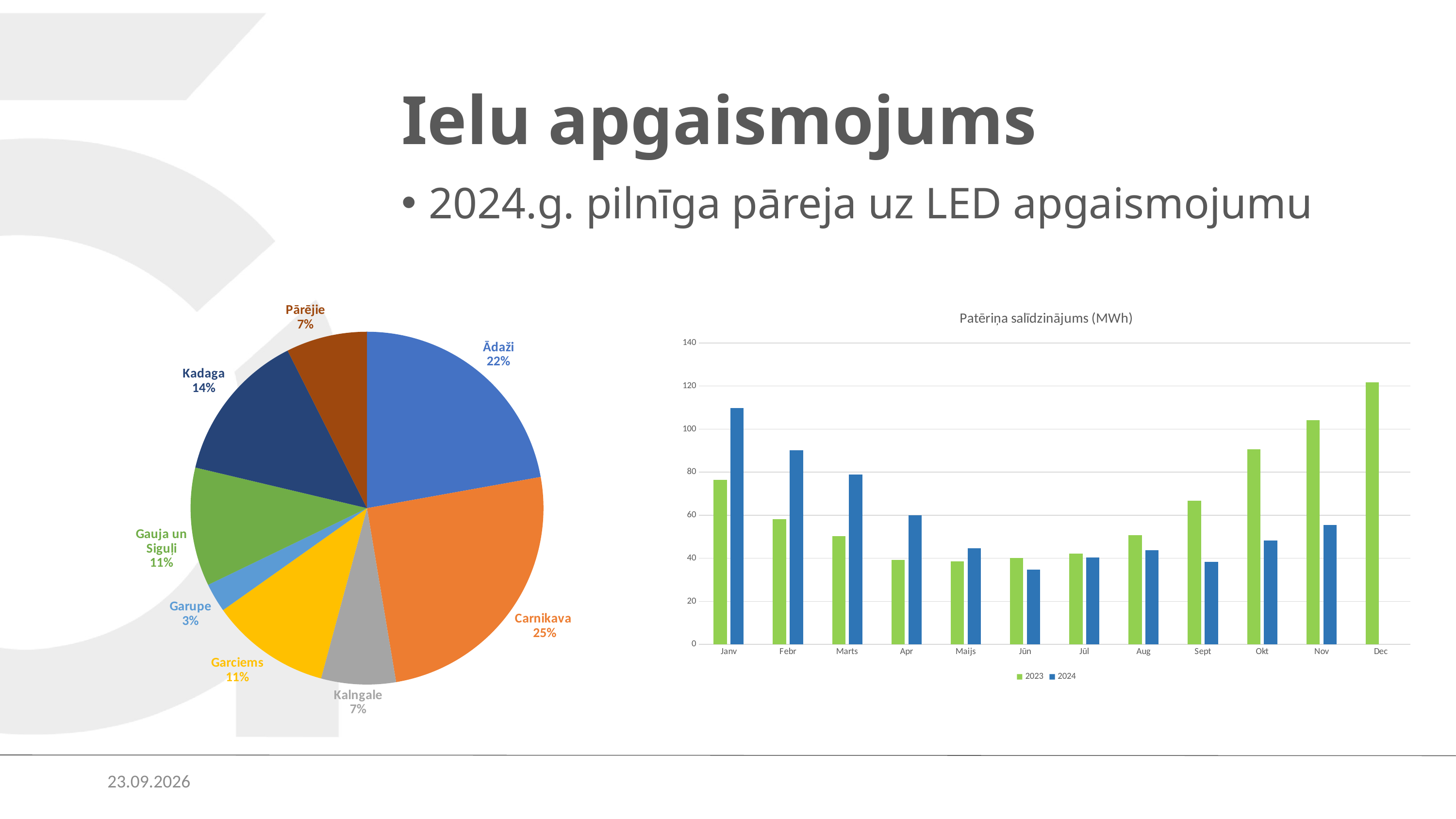
In the pie chart on the left, which category has the largest share? Carnikava In the chart 'Patēriņa salīdzinājums (MWh)', how many series does the legend list? 2 In the pie chart on the left, what is the difference between the shares of Ādaži and Kalngale? 15% In the chart 'Patēriņa salīdzinājums (MWh)', is the 2024 value for Jūn greater or less than 40? less In the pie chart on the left, what share does Kadaga have? 14% In the chart 'Patēriņa salīdzinājums (MWh)', how many months are shown on the x axis? 12 In the pie chart on the left, which category has the smallest share? Garupe What type of chart is the chart titled 'Patēriņa salīdzinājums (MWh)'? bar chart In the pie chart on the left, how many slices are there? 8 In the chart 'Patēriņa salīdzinājums (MWh)', which month has the highest 2023 value? Dec In the pie chart on the left, what share does Carnikava have? 25% In the chart 'Patēriņa salīdzinājums (MWh)', is the 2024 value for Janv greater or less than 100? greater